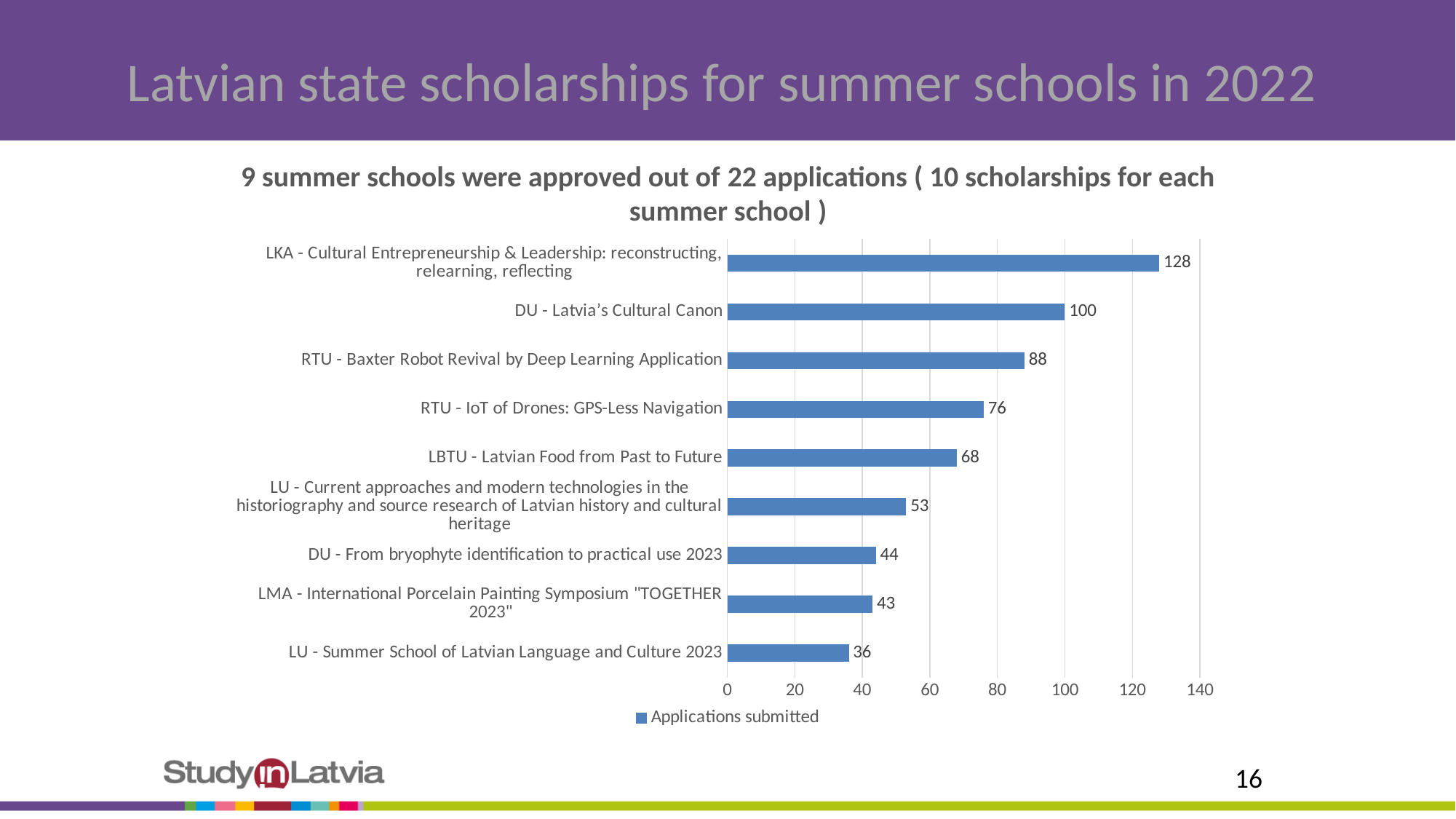
What kind of chart is shown on the slide? Bar chart Which summer school received the fewest applications? LU - Summer School of Latvian Language and Culture 2023 Which summer school received the most applications? LKA - Cultural Entrepreneurship & Leadership: reconstructing, relearning, reflecting Which received more applications: RTU - Baxter Robot Revival by Deep Learning Application or LBTU - Latvian Food from Past to Future? RTU - Baxter Robot Revival by Deep Learning Application Is the value for DU - From bryophyte identification to practical use 2023 greater or less than 60? less How many applications were submitted for LU - Summer School of Latvian Language and Culture 2023? 36 What is the difference in applications submitted between LKA - Cultural Entrepreneurship & Leadership and DU - Latvia's Cultural Canon? 28 How many summer schools are shown in the chart? 9 How many applications were submitted for RTU - IoT of Drones: GPS-Less Navigation? 76 How many applications were submitted for DU - Latvia's Cultural Canon? 100 What is the legend entry of the chart? Applications submitted How many series does the legend list? 1